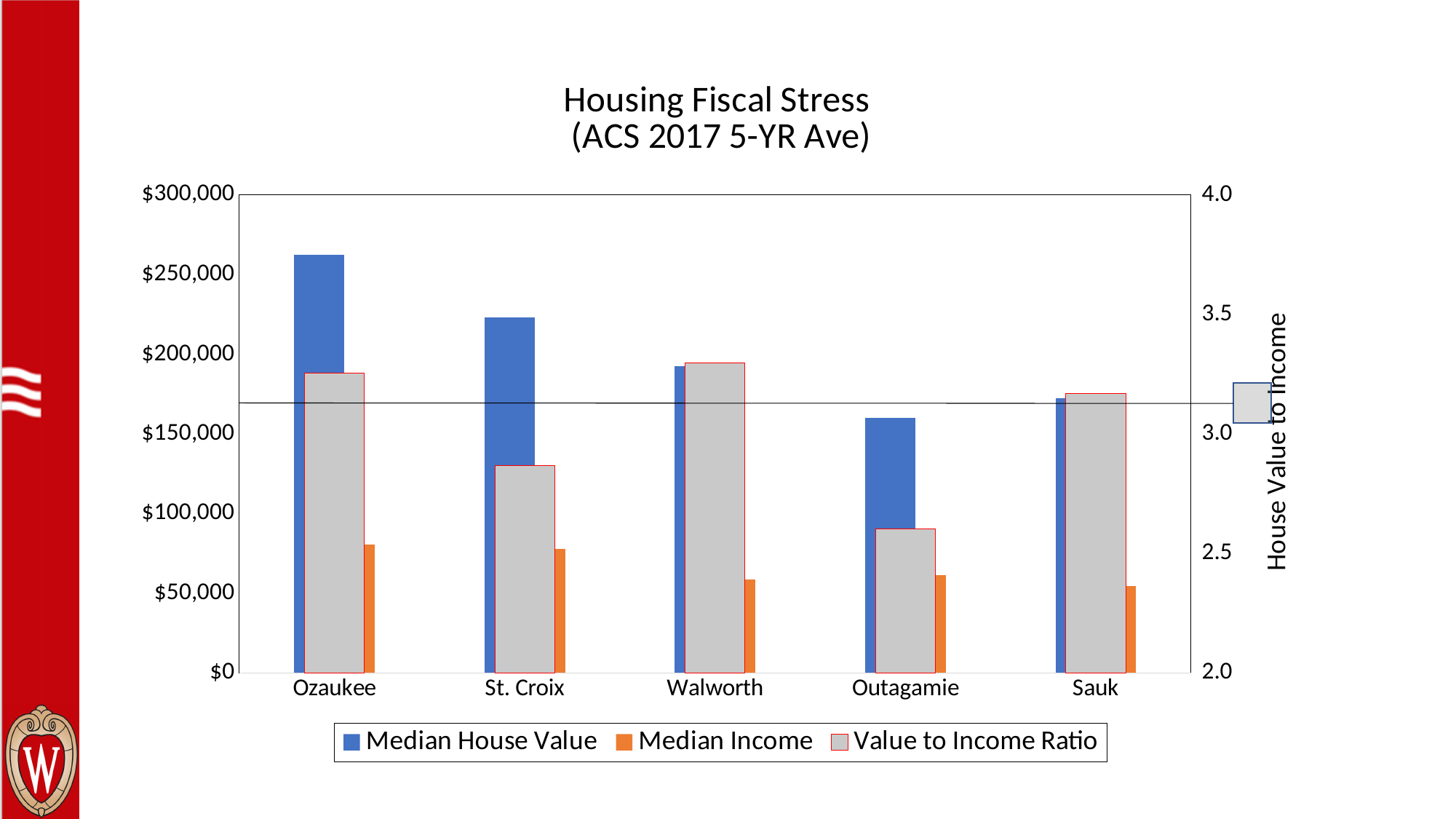
Which has the larger Median House Value, Ozaukee or St. Croix? Ozaukee Is the Value to Income Ratio for Outagamie greater or less than 3.0? less What kind of chart is shown on the slide? Bar chart What is the label of the secondary (right-hand) vertical axis? House Value to Income How many series does the legend list? 3 Is the Median Income for Walworth greater or less than $50,000? greater Is the Median House Value for St. Croix greater or less than $200,000? greater Which county has the lowest Value to Income Ratio? Outagamie Which county has the lowest Median House Value? Outagamie How many counties are shown on the x axis of the chart? 5 Which county has the highest Median House Value? Ozaukee